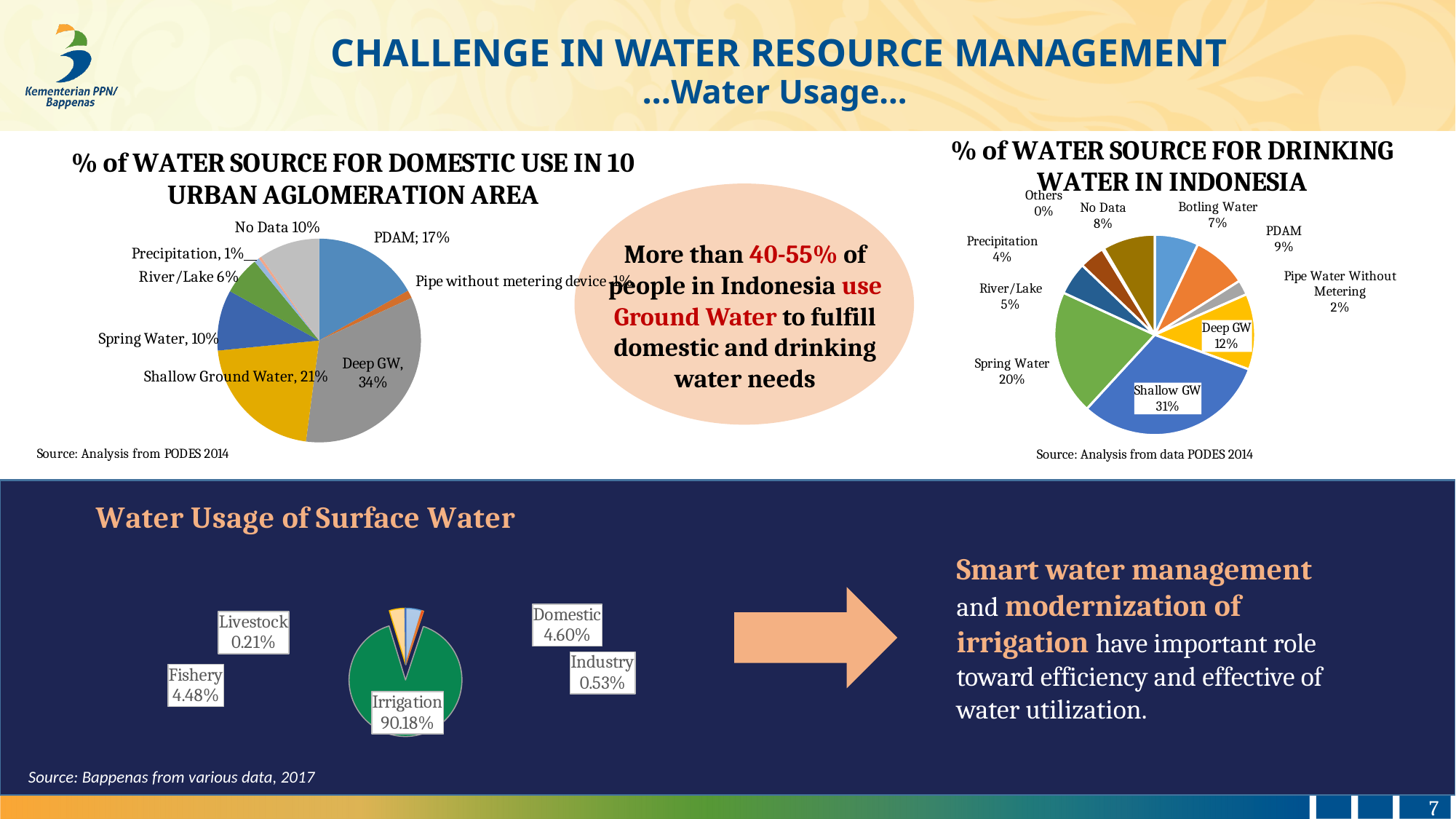
In the '% of WATER SOURCE FOR DRINKING WATER IN INDONESIA' chart, what is the share for Shallow GW? 31% In the '% of WATER SOURCE FOR DOMESTIC USE IN 10 URBAN AGLOMERATION AREA' chart, what is the share for Deep GW? 34% What kind of chart is the 'Water Usage of Surface Water' chart? Pie chart In the '% of WATER SOURCE FOR DRINKING WATER IN INDONESIA' chart, what is the share for Spring Water? 20% In the '% of WATER SOURCE FOR DRINKING WATER IN INDONESIA' chart, which is larger, PDAM or Botling Water? PDAM In the '% of WATER SOURCE FOR DOMESTIC USE IN 10 URBAN AGLOMERATION AREA' chart, which category has the largest share? Deep GW In the 'Water Usage of Surface Water' chart, which is larger, Fishery or Domestic? Domestic In the '% of WATER SOURCE FOR DRINKING WATER IN INDONESIA' chart, which category has the smallest share? Others In the '% of WATER SOURCE FOR DOMESTIC USE IN 10 URBAN AGLOMERATION AREA' chart, what is the share for Shallow Ground Water? 21% In the '% of WATER SOURCE FOR DOMESTIC USE IN 10 URBAN AGLOMERATION AREA' chart, what is the difference between PDAM and River/Lake? 11% How many categories are shown in the '% of WATER SOURCE FOR DRINKING WATER IN INDONESIA' chart? 10 In the 'Water Usage of Surface Water' chart, what is the share for Irrigation? 90.18%